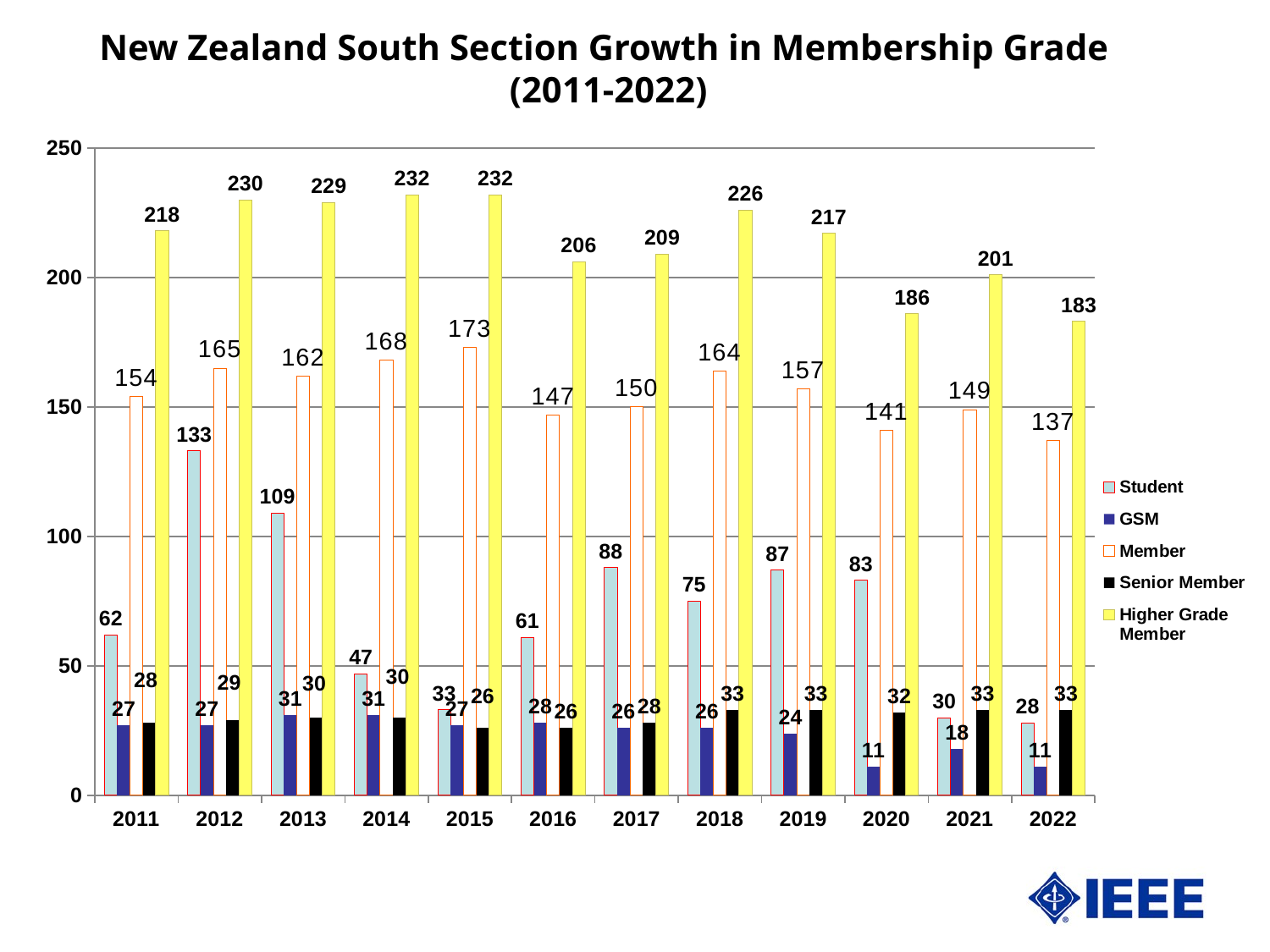
Which series is shown in yellow? Higher Grade Member What is the Member value for 2020? 141 What is the Student value for 2012? 133 How many years are shown on the x axis? 12 Which year has the lowest Higher Grade Member value? 2022 Which is larger, the Student value for 2017 or the Student value for 2019? 2017 What is the difference between the Higher Grade Member values for 2012 and 2022? 47 Which year has the highest Member value? 2015 What is the GSM value for 2021? 18 What is the Higher Grade Member value for 2014? 232 What kind of chart is shown on the slide? Bar chart How many series does the legend list? 5